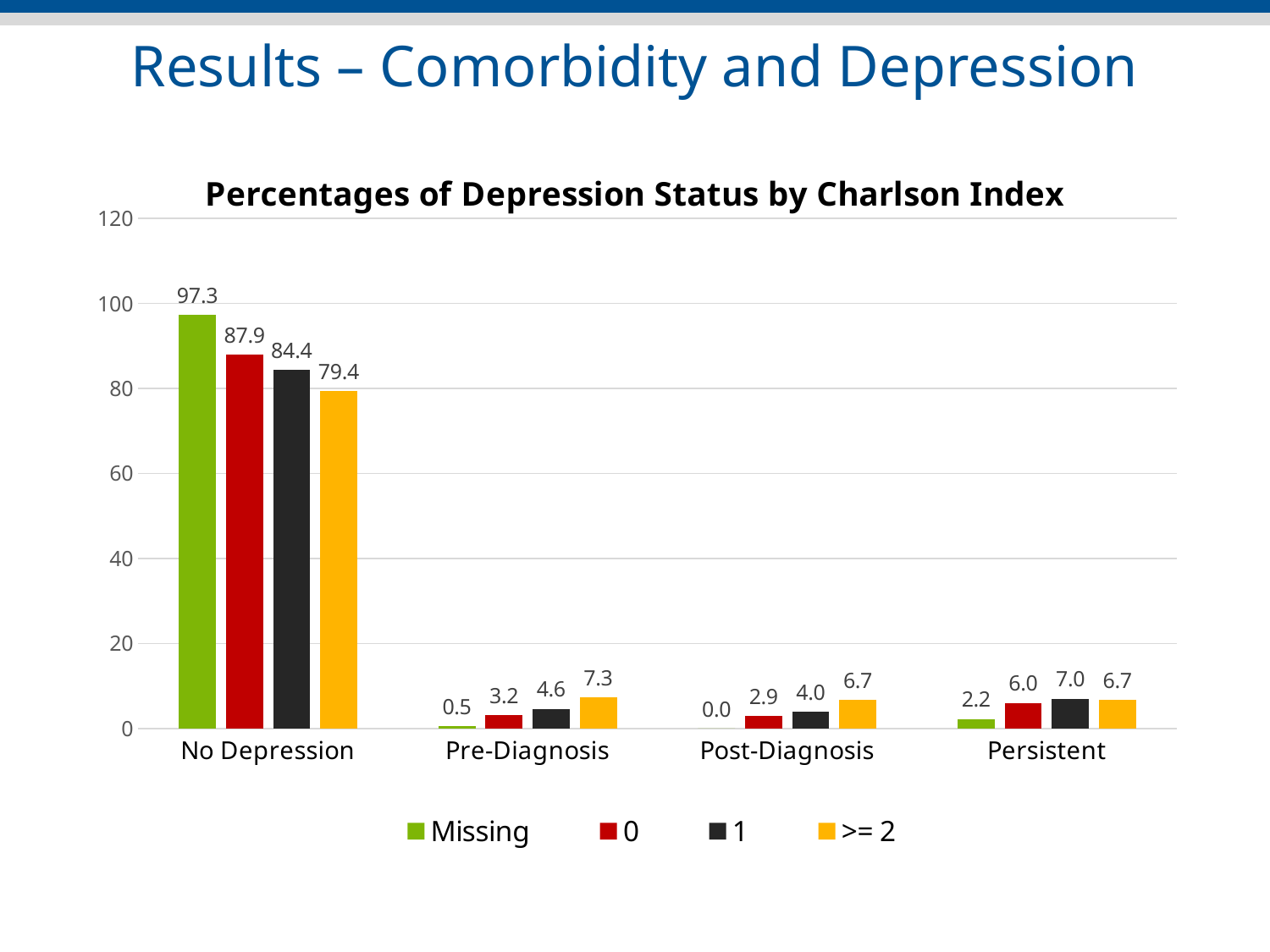
Which series has the highest value in the No Depression category? Missing What is the value for the 0 series in the Post-Diagnosis category? 2.9 What kind of chart is shown on the slide? Bar chart Which is larger in the Persistent category: the value for 0 or the value for 1? 1 What is the difference between the Missing and >= 2 values in the No Depression category? 17.9 What is the value for the Missing series in the No Depression category? 97.3 What is the value for the 1 series in the Persistent category? 7.0 How many series does the legend list? 4 Is the value for the 0 series in the No Depression category greater or less than 80? greater Which series has the lowest value in the Post-Diagnosis category? Missing What is the value for the >= 2 series in the Pre-Diagnosis category? 7.3 How many categories are shown on the x axis? 4